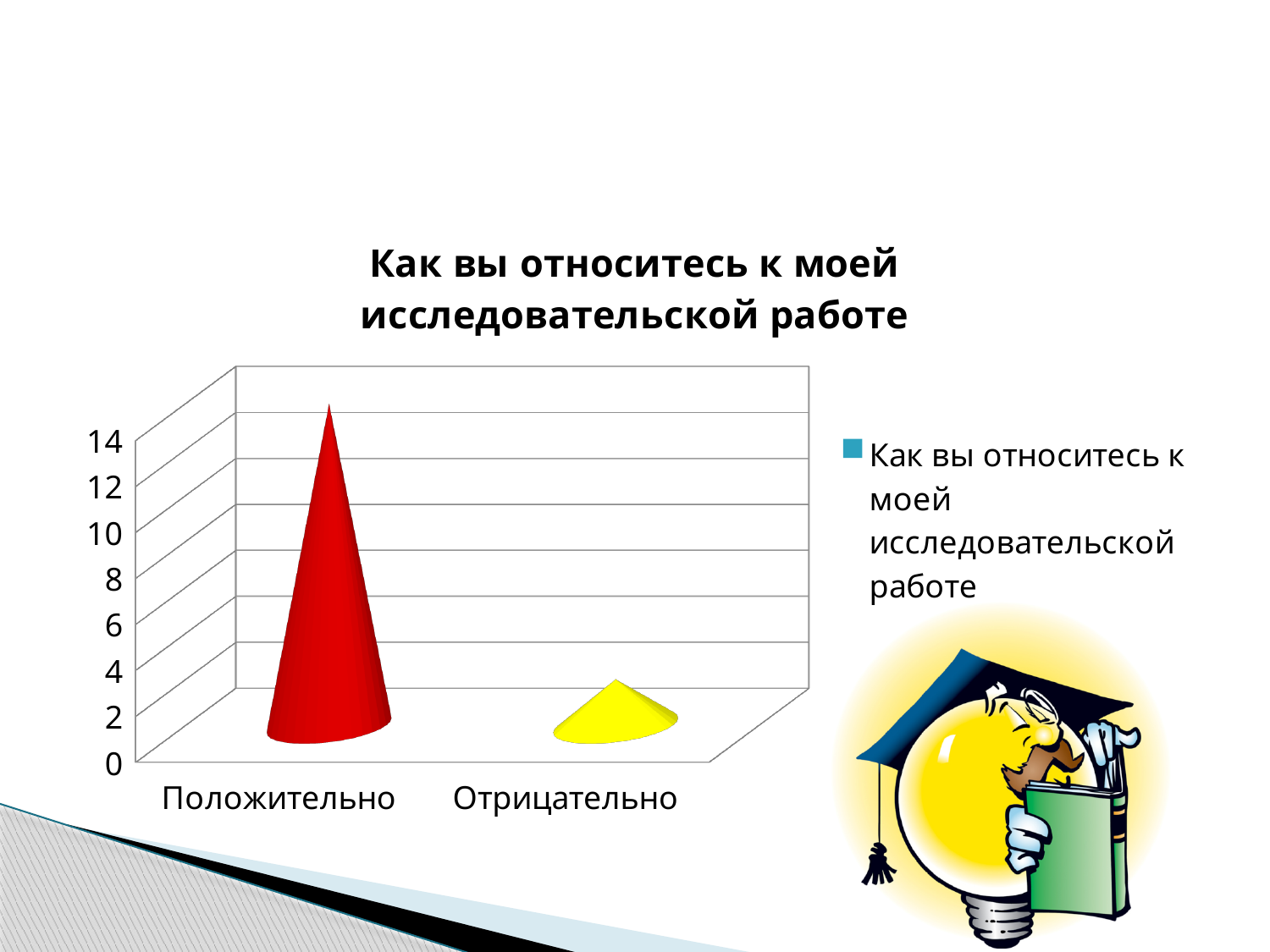
What colour is the bar for Положительно? red Which category has the lowest value? Отрицательно Is the value for Отрицательно greater or less than 4? less Is the value for Положительно greater or less than 10? greater Is the value for Положительно greater or less than 6? greater How many categories are shown on the x axis of the chart? 2 Which category has the highest value? Положительно What kind of chart is shown on the slide? bar chart Which is larger, the value for Положительно or the value for Отрицательно? Положительно How many series does the chart's legend list? 1 What is the title of the chart? Как вы относитесь к моей исследовательской работе